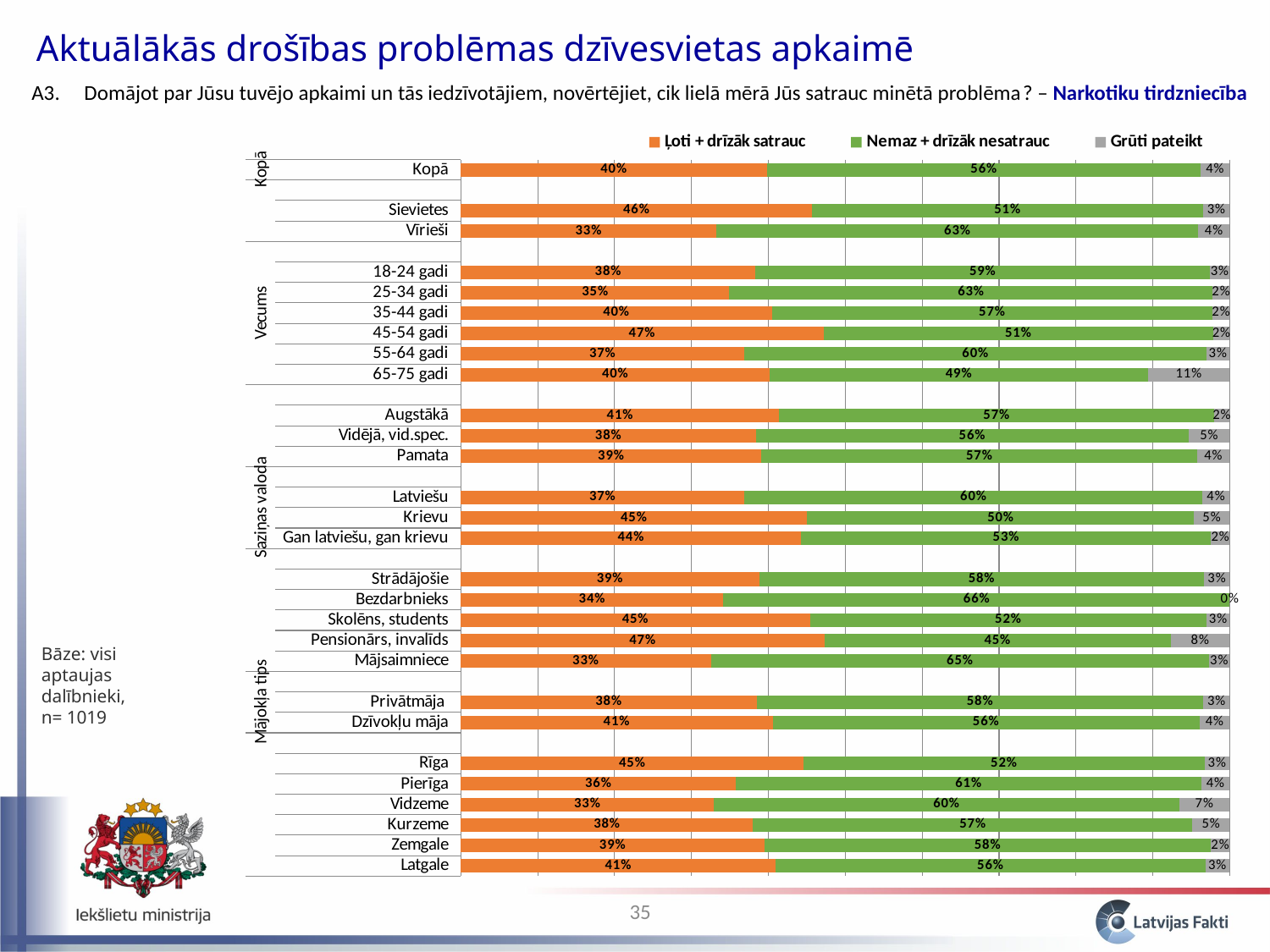
What is the difference in the "Ļoti + drīzāk satrauc" share between Sievietes and Vīrieši? 13 percentage points Which category has the lowest "Grūti pateikt" share? Bezdarbnieks Which category has the highest "Grūti pateikt" share? 65-75 gadi What is the total of the three segments in the Kopā bar? 100% What percentage of all respondents (Kopā) answered "Ļoti + drīzāk satrauc"? 40% What kind of chart is shown on the slide? Stacked bar chart Which has a larger "Ļoti + drīzāk satrauc" share, Latviešu or Krievu? Krievu What is the "Nemaz + drīzāk nesatrauc" value for Bezdarbnieks? 66% How many series does the legend list? 3 Which category has the highest "Nemaz + drīzāk nesatrauc" share? Bezdarbnieks What is the "Grūti pateikt" value for the 65-75 gadi group? 11% What is the "Nemaz + drīzāk nesatrauc" value for Vīrieši? 63%